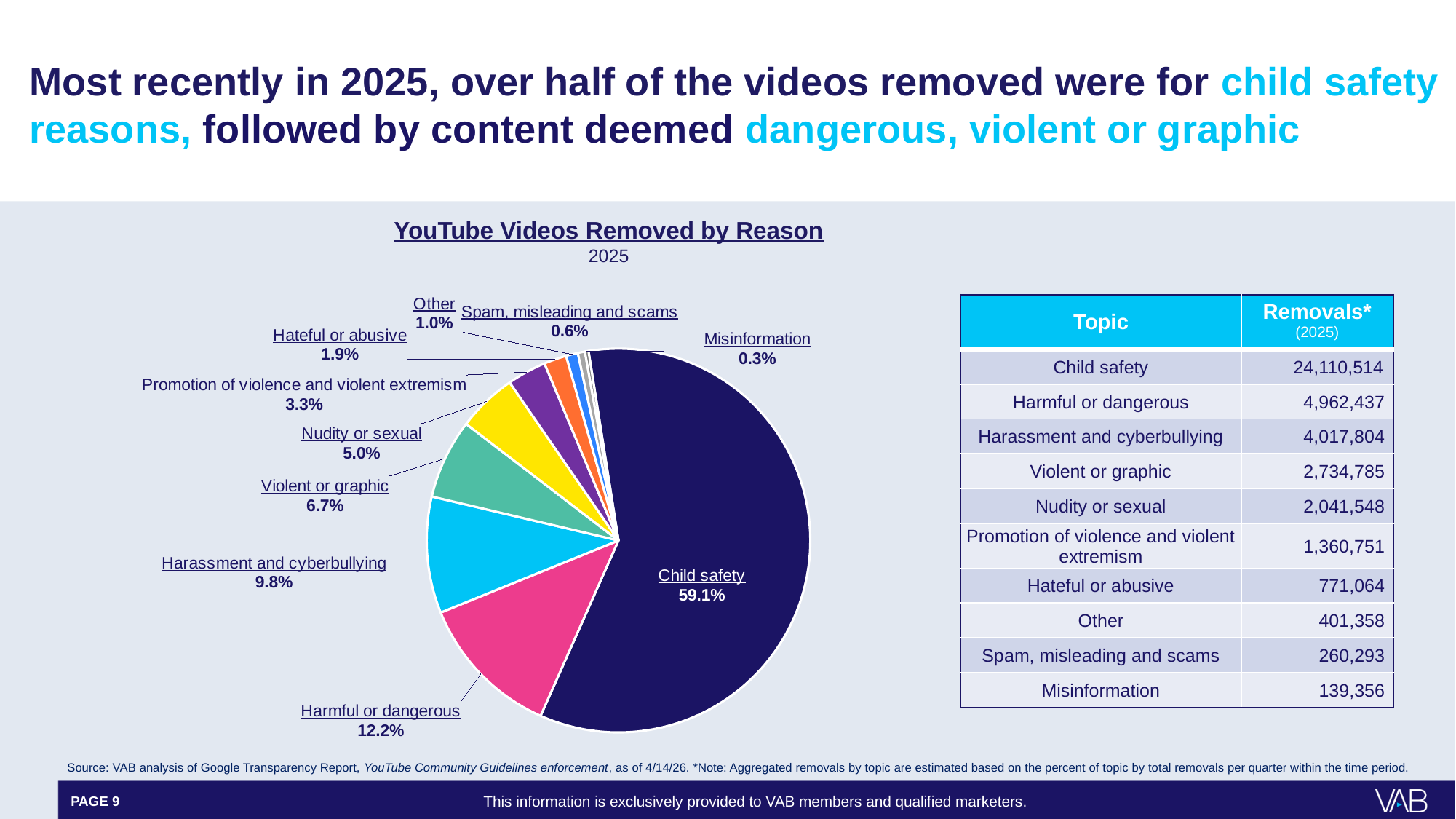
Which reason has the smallest slice of the pie? Misinformation What is the value shown for Spam, misleading and scams? 0.6% Which reason has the largest slice of the pie? Child safety What is the value shown for Harmful or dangerous? 12.2% What is the title of the chart? YouTube Videos Removed by Reason What is the difference in percentage points between Child safety and Harmful or dangerous? 46.9 percentage points How many slices does the pie chart have? 10 What is the value shown for Harassment and cyberbullying? 9.8% What kind of chart is shown on the slide? Pie chart What is the value shown for Nudity or sexual? 5.0% Which is larger, Violent or graphic or Nudity or sexual? Violent or graphic What share of the pie does Child safety account for? 59.1%